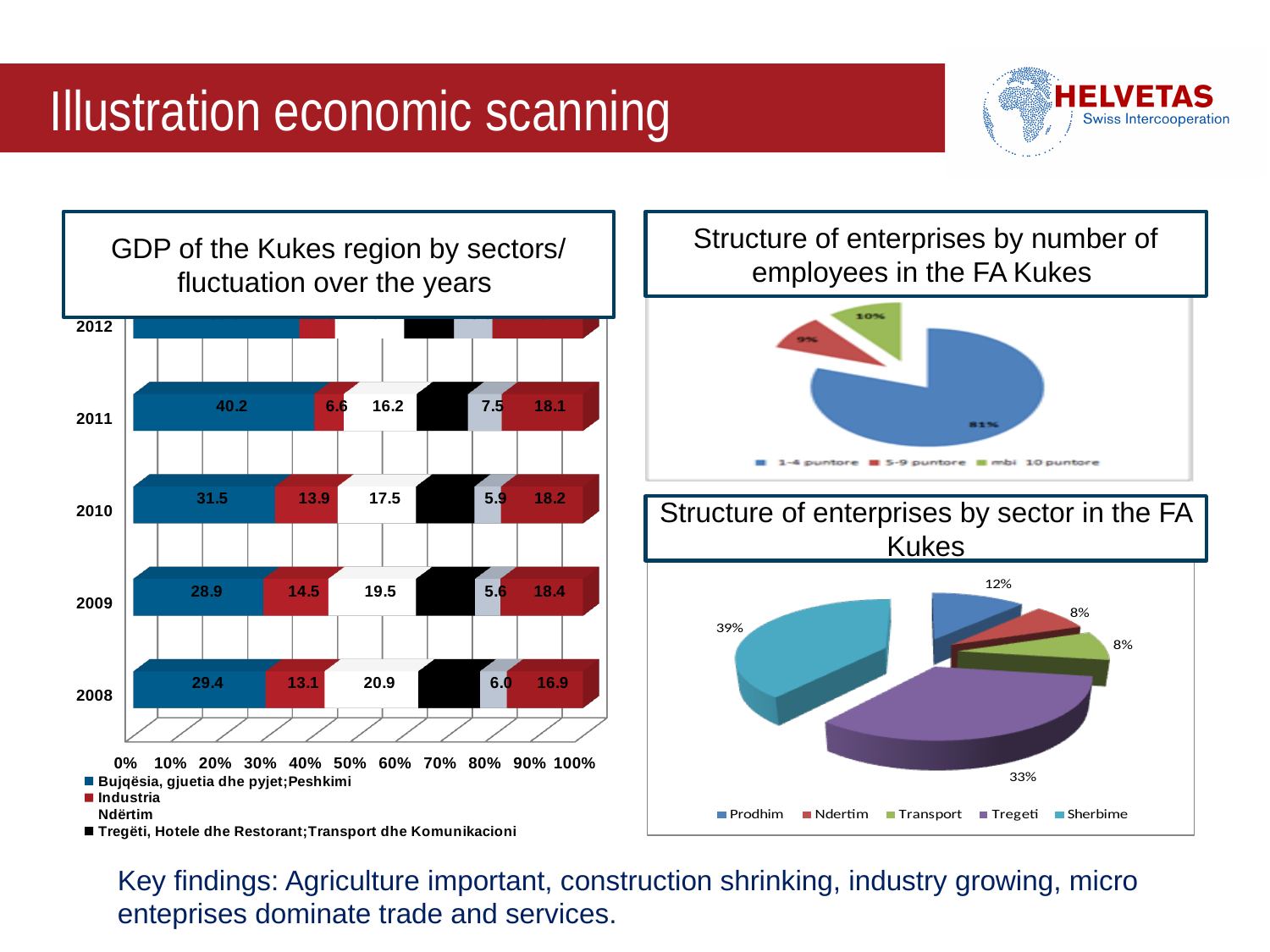
In the GDP of the Kukes region by sectors chart, what is the value for Bujqësia, gjuetia dhe pyjet;Peshkimi in 2011? 40.2 In the GDP of the Kukes region by sectors chart, what is the value for Industria in 2010? 13.9 How many years are shown in the GDP of the Kukes region by sectors chart? 5 In the GDP of the Kukes region by sectors chart, what is the value for Ndërtim in 2008? 20.9 In the Structure of enterprises by sector pie chart, what share does Sherbime have? 39% In the Structure of enterprises by number of employees pie chart, what share do enterprises with 1-4 puntore have? 81% In the Structure of enterprises by sector pie chart, which sector has the largest share? Sherbime In the GDP of the Kukes region by sectors chart, which year has the larger Industria value, 2009 or 2011? 2009 How many entries does the legend of the Structure of enterprises by sector pie chart list? 5 What kind of chart is the GDP of the Kukes region by sectors chart? bar chart In the GDP of the Kukes region by sectors chart, what is the difference between the Bujqësia, gjuetia dhe pyjet;Peshkimi values for 2011 and 2010? 8.7 In the GDP of the Kukes region by sectors chart, does the Ndërtim value rise or fall from 2008 to 2011? fall